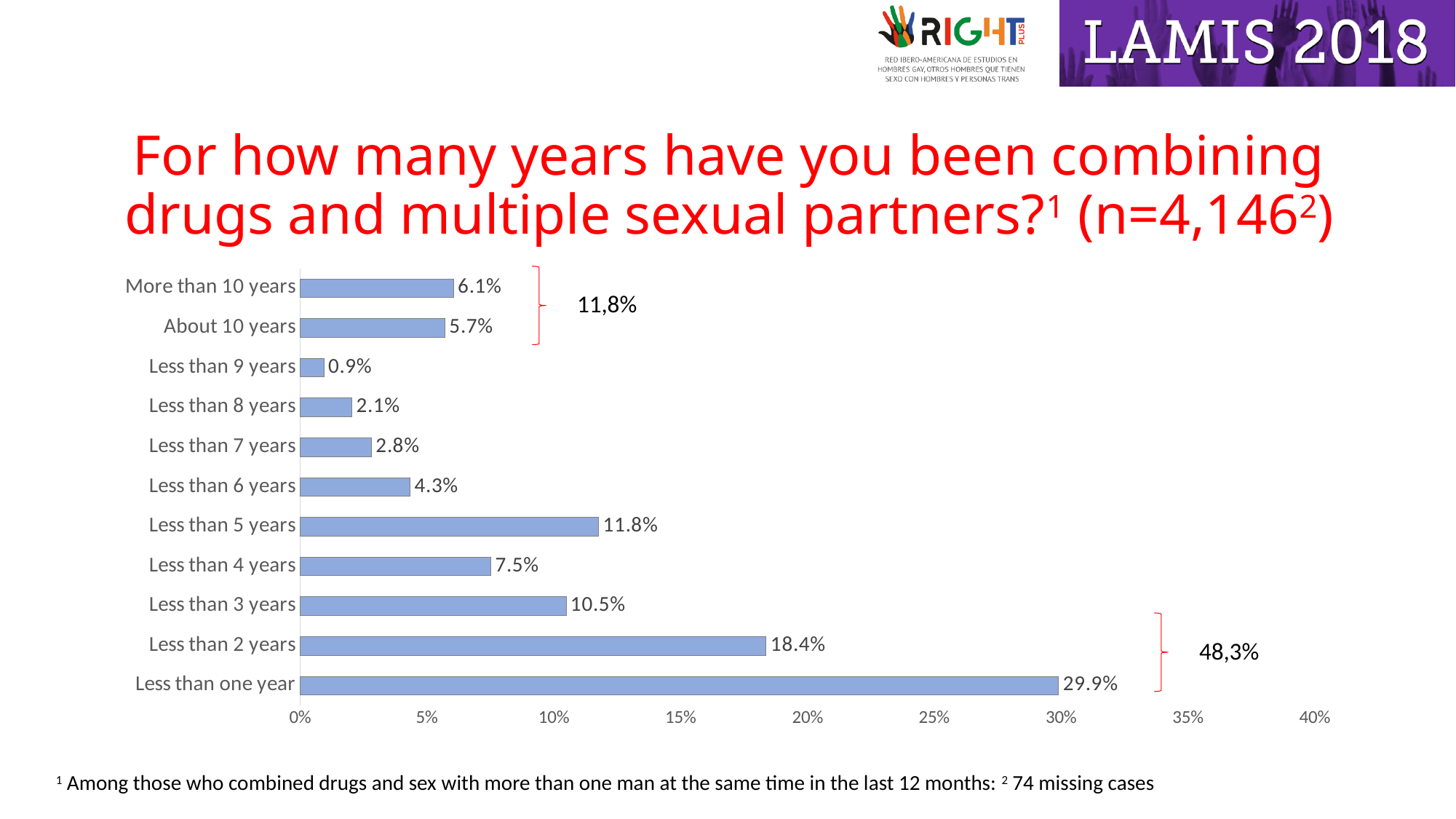
How many categories are shown in the chart? 11 What is the value for "About 10 years"? 5.7% Which category has the highest value? Less than one year Which is larger, "Less than 3 years" or "Less than 4 years"? Less than 3 years What combined percentage is annotated for "More than 10 years" and "About 10 years" together? 11,8% What is the value for "Less than one year"? 29.9% What combined percentage is annotated for "Less than 2 years" and "Less than one year" together? 48,3% What kind of chart is shown on the slide? bar chart Is the value for "Less than 2 years" greater or less than 15%? greater Which category has the lowest value? Less than 9 years What is the difference between "Less than one year" and "Less than 2 years"? 11.5% What is the value for "Less than 5 years"? 11.8%